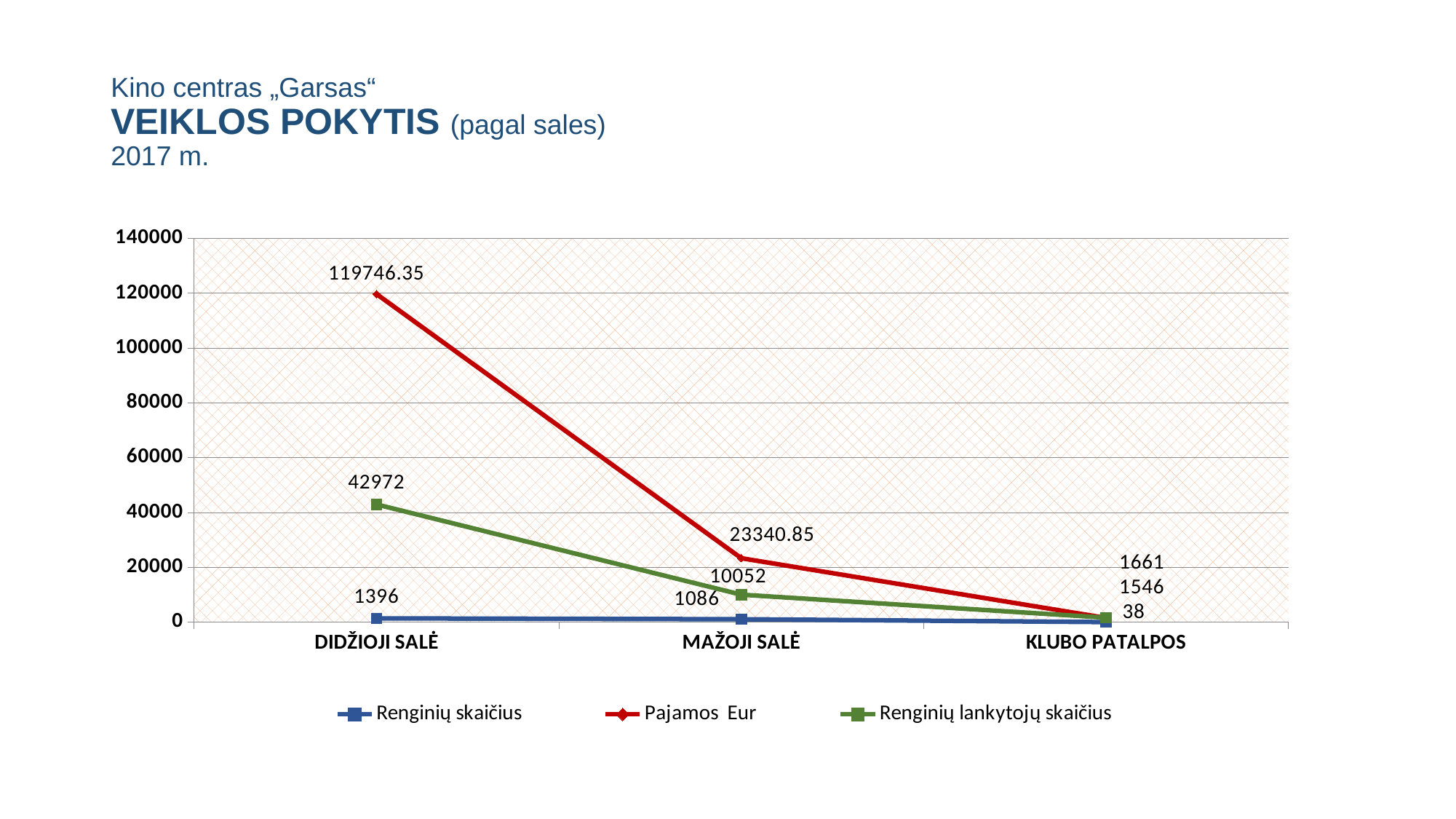
Does Pajamos Eur rise or fall from DIDŽIOJI SALĖ to KLUBO PATALPOS? fall Which is larger, Renginių skaičius for DIDŽIOJI SALĖ or for MAŽOJI SALĖ? DIDŽIOJI SALĖ Which category has the highest Pajamos Eur? DIDŽIOJI SALĖ How many categories are shown on the x axis? 3 What is the value of Pajamos Eur for MAŽOJI SALĖ? 23340.85 What is the value of Renginių skaičius for DIDŽIOJI SALĖ? 1396 What is the difference between Renginių lankytojų skaičius for DIDŽIOJI SALĖ and MAŽOJI SALĖ? 32920 How many series does the legend list? 3 What is the value of Renginių lankytojų skaičius for MAŽOJI SALĖ? 10052 What kind of chart is shown on the slide? line chart What is the value of Pajamos Eur for DIDŽIOJI SALĖ? 119746.35 What is the difference between Pajamos Eur for DIDŽIOJI SALĖ and MAŽOJI SALĖ? 96405.5